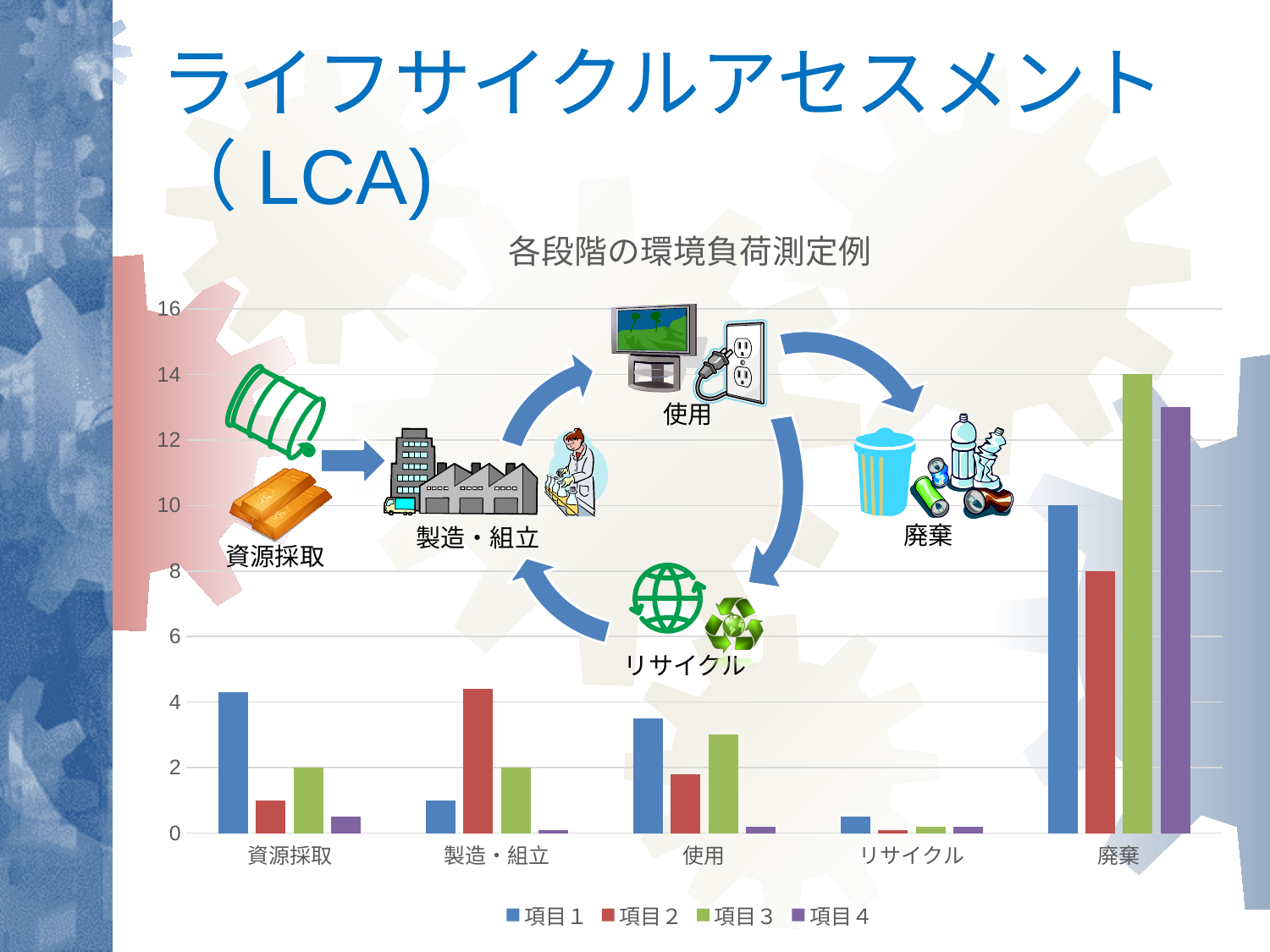
What kind of chart is shown on the slide? bar chart How many categories are shown on the x axis? 5 What is the value of 項目3 for 廃棄? 14 Which category has the highest value for 項目2? 廃棄 What is the title of the chart? 各段階の環境負荷測定例 Is the value of 項目4 for 廃棄 greater or less than 12? greater What is the value of 項目1 for 廃棄? 10 Which category has the highest value for 項目3? 廃棄 For 製造・組立, which is larger, 項目1 or 項目2? 項目2 Which category has the lowest value for 項目1? リサイクル How many series does the legend list? 4